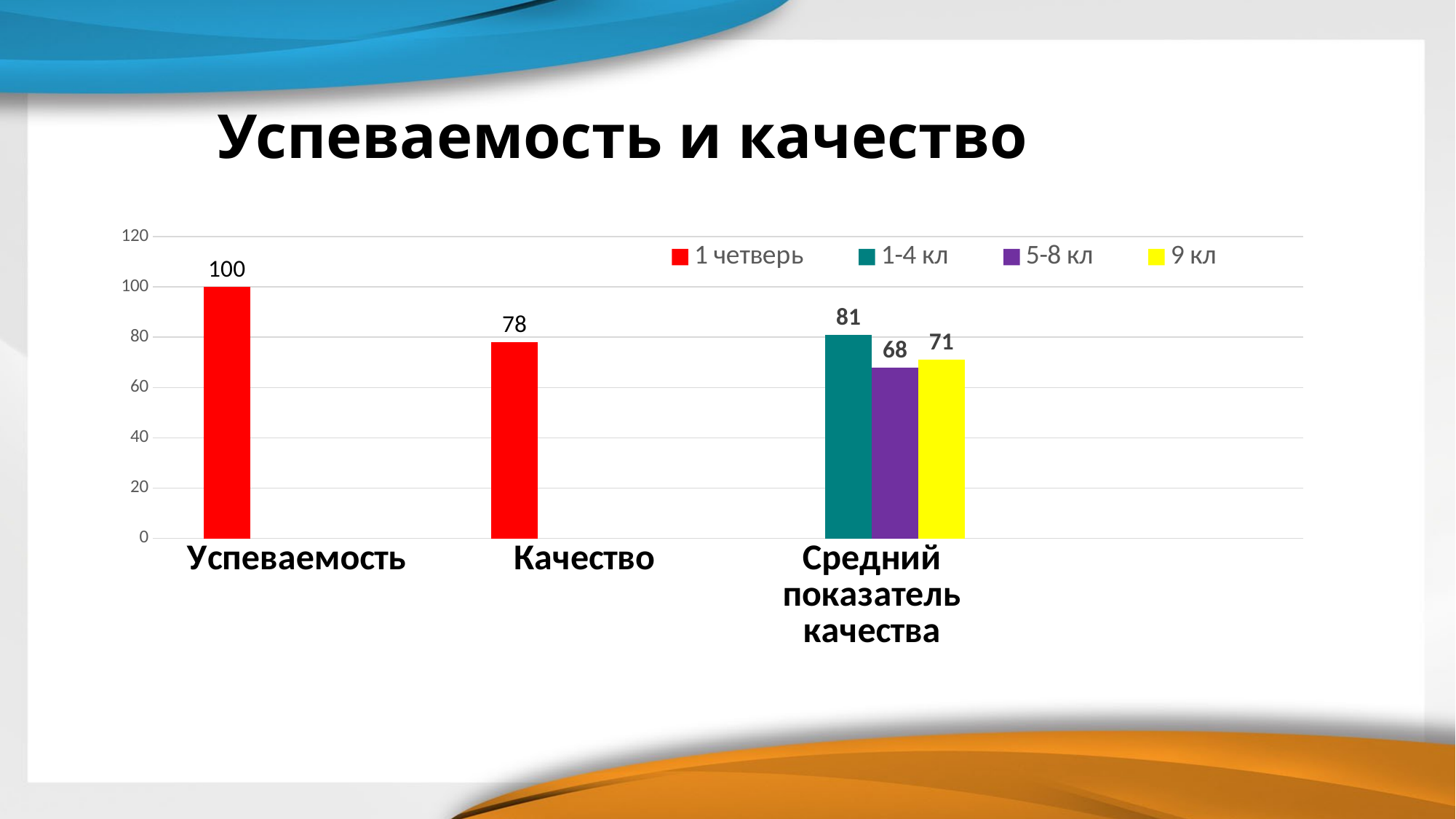
Which is larger under Средний показатель качества: the value for 9 кл or the value for 5-8 кл? 9 кл What is the value for Успеваемость in the 1 четверь series? 100 How many series does the legend list? 4 What is the value for 9 кл under Средний показатель качества? 71 What is the difference between the Успеваемость value and the Качество value? 22 What is the value for Качество in the 1 четверь series? 78 Which series has the lowest value under Средний показатель качества? 5-8 кл What kind of chart is shown on the slide? Bar chart Which series has the highest value under Средний показатель качества? 1-4 кл What is the value for 1-4 кл under Средний показатель качества? 81 What is the value for 5-8 кл under Средний показатель качества? 68 What is the title of the slide? Успеваемость и качество